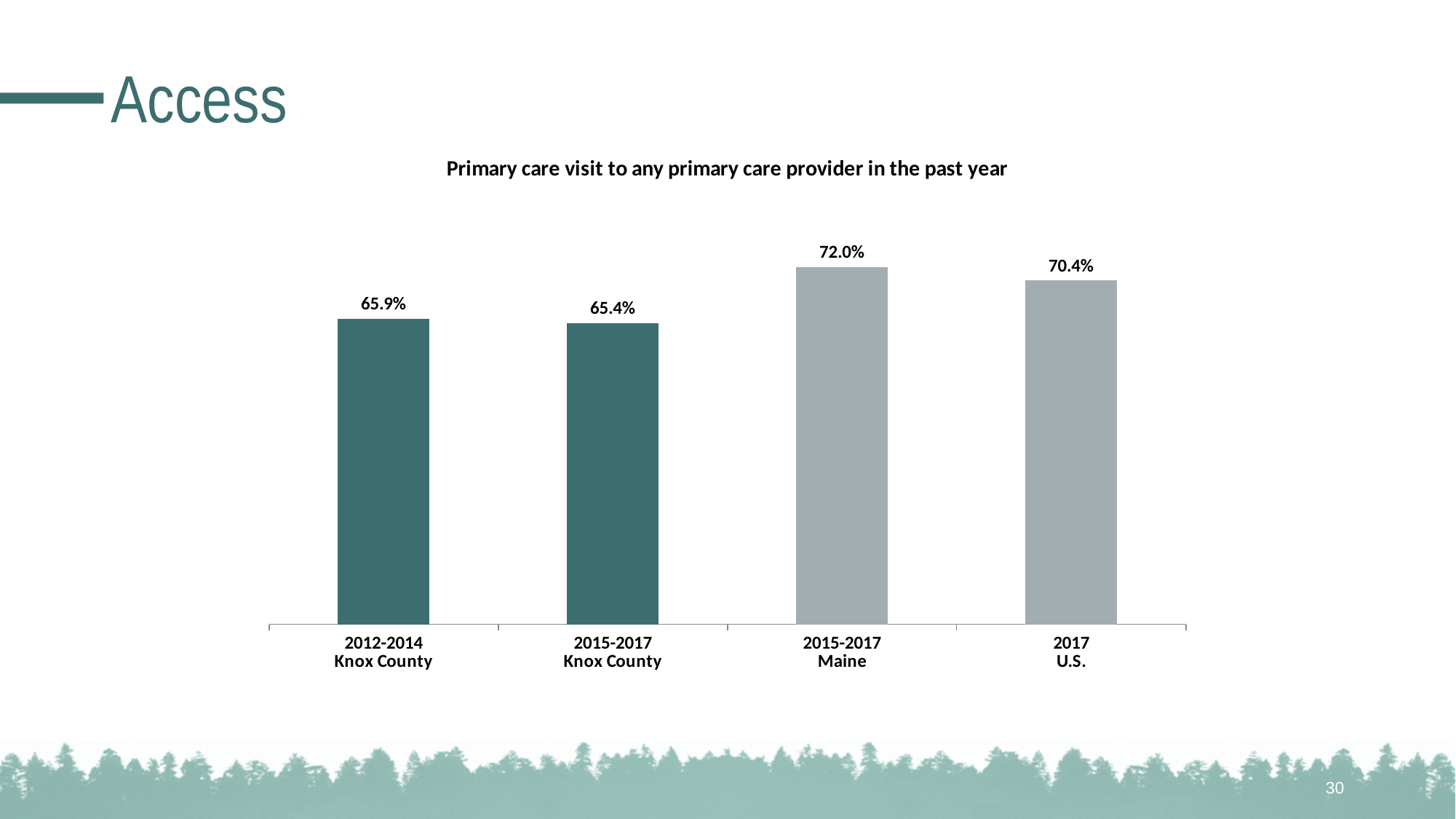
What is the value for 2015-2017 Knox County? 65.4% What is the value for 2015-2017 Maine? 72.0% What is the value for 2012-2014 Knox County? 65.9% Which is larger, the value for 2015-2017 Maine or the value for 2017 U.S.? 2015-2017 Maine Which category has the lowest value? 2015-2017 Knox County What is the title of the chart? Primary care visit to any primary care provider in the past year How many categories are shown in the chart? 4 What is the value for 2017 U.S.? 70.4% What is the difference between the values for 2017 U.S. and 2012-2014 Knox County? 4.5 percentage points What is the difference between the values for 2015-2017 Maine and 2015-2017 Knox County? 6.6 percentage points What kind of chart is shown on the slide? Bar chart Which category has the highest value? 2015-2017 Maine